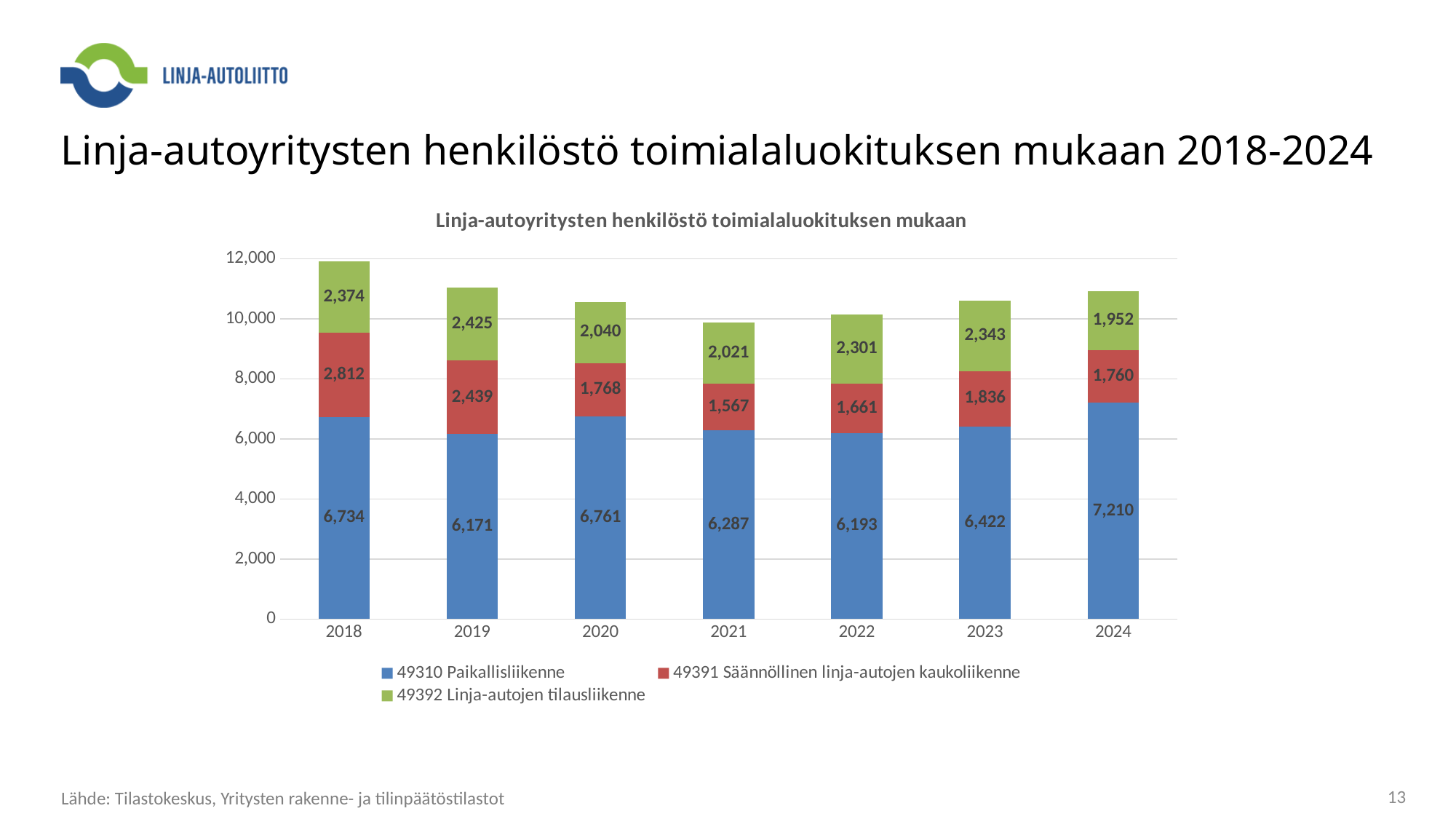
In which year is the value for 49391 Säännöllinen linja-autojen kaukoliikenne the lowest? 2021 What is the total of the stacked bar for 2021? 9,875 What is the difference between the 49392 Linja-autojen tilausliikenne values in 2019 and 2024? 473 In which year is the value for 49310 Paikallisliikenne the highest? 2024 What is the total of the stacked bar for 2018? 11,920 What kind of chart is shown on the slide? Stacked bar chart Which is larger, the 49310 Paikallisliikenne value in 2020 or in 2023? 2020 How many years are shown on the x axis? 7 What is the value for 49392 Linja-autojen tilausliikenne in 2021? 2,021 How many series does the legend list? 3 What is the value for 49310 Paikallisliikenne in 2024? 7,210 What is the value for 49391 Säännöllinen linja-autojen kaukoliikenne in 2018? 2,812